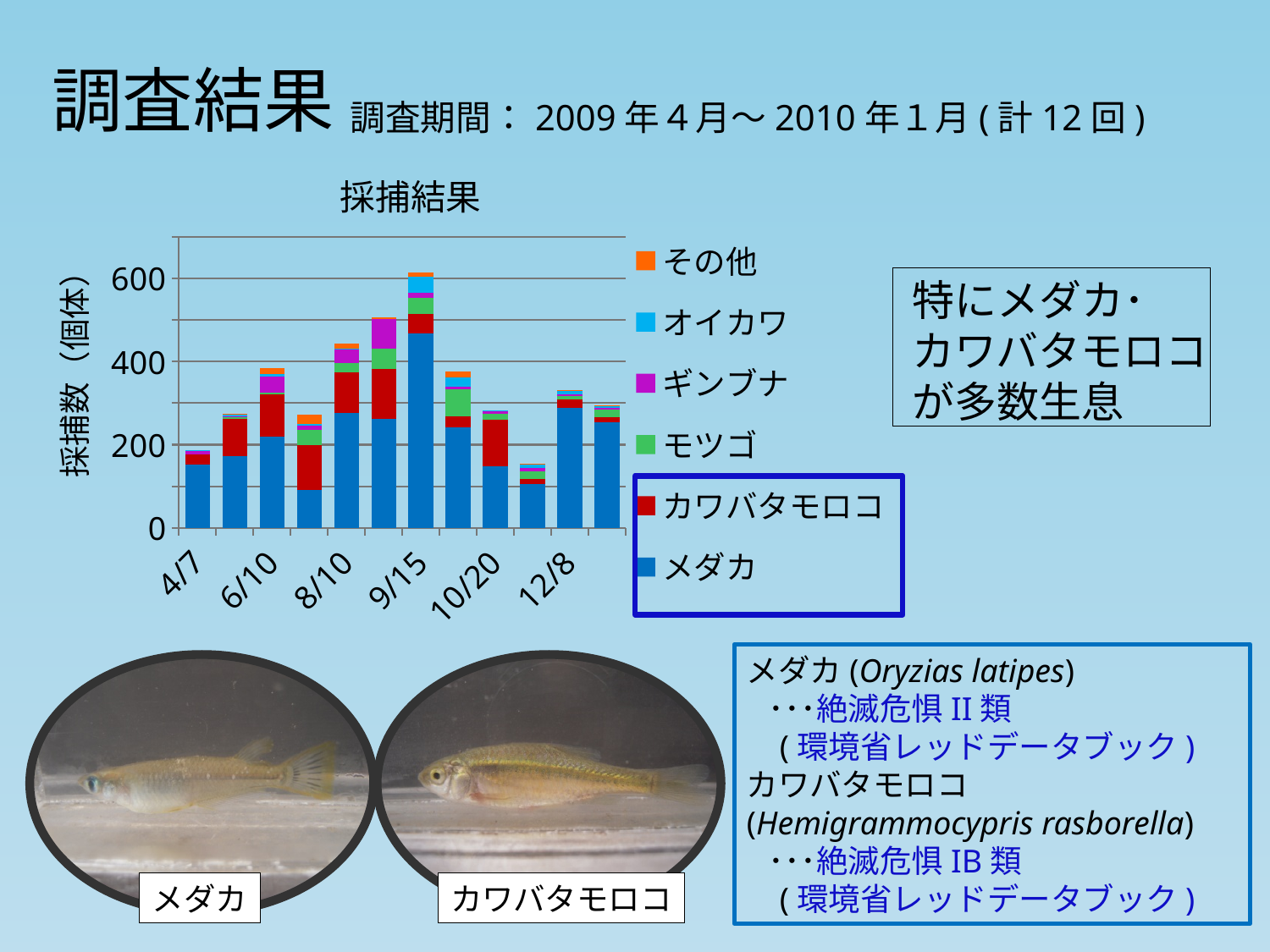
How many series does the chart legend list? 6 Which series is listed at the bottom of the legend? メダカ Which labeled date has the tallest bar in the chart? 9/15 What is the title of the chart? 採捕結果 Is the total for 8/10 greater or less than 400? greater What kind of chart is shown on the slide? stacked bar chart Is the total for 12/8 greater or less than 200? greater How many bars are plotted in the chart? 12 Which bar is taller, 9/15 or 4/7? 9/15 Which bar is taller, 12/8 or 4/7? 12/8 Is the total for 4/7 greater or less than 200? less